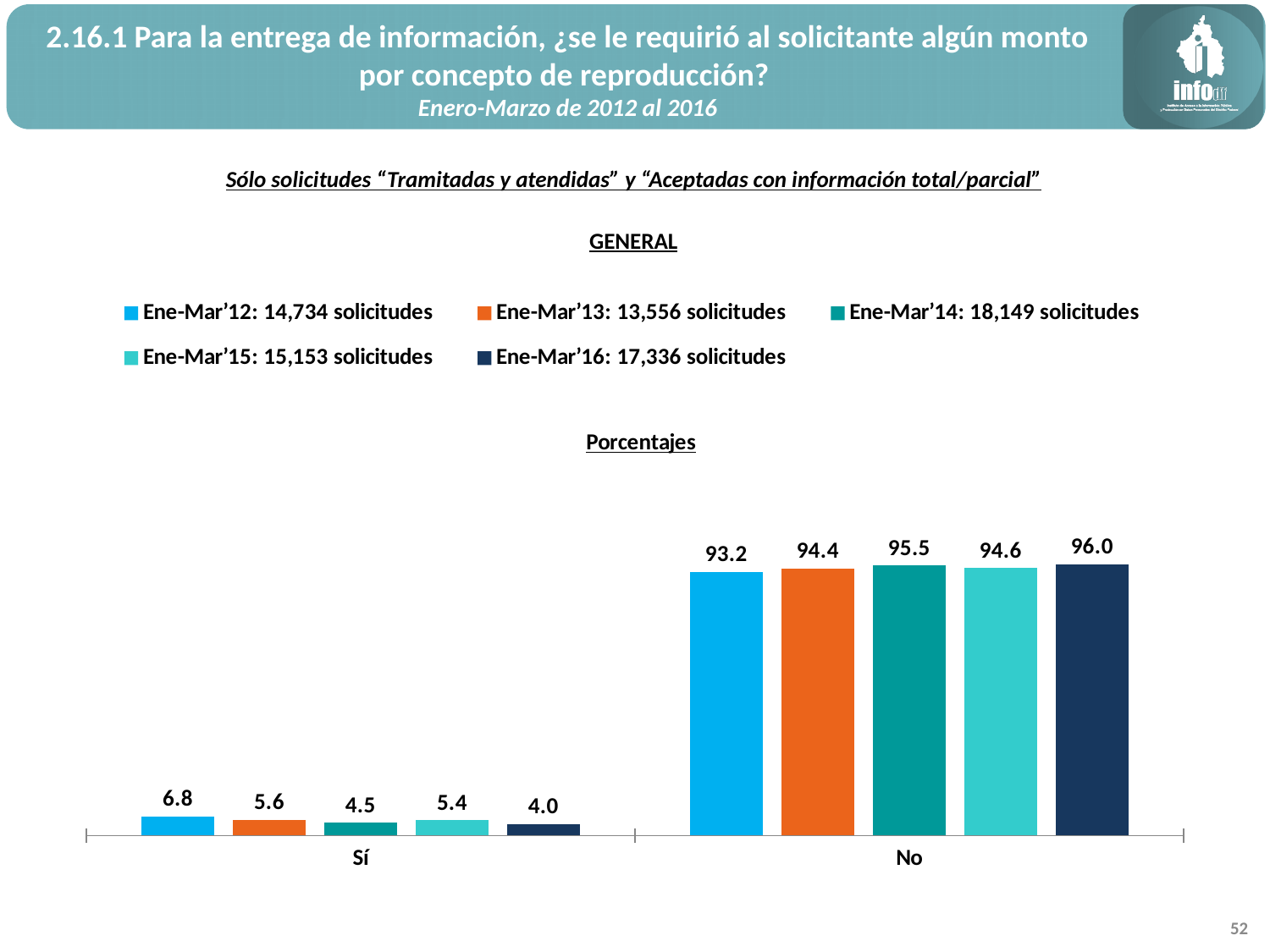
Which series has the lowest value in the Sí category? Ene-Mar'16 Which is larger in the No category: Ene-Mar'13 or Ene-Mar'15? Ene-Mar'15 What is the value for Ene-Mar'14 in the Sí category? 4.5 How many categories are shown on the x axis? 2 What is the value for Ene-Mar'12 in the Sí category? 6.8 Which series has the highest value in the No category? Ene-Mar'16 What is the difference between the Ene-Mar'14 and Ene-Mar'12 values in the No category? 2.3 How many series does the legend list? 5 How many solicitudes does the legend give for Ene-Mar'14? 18,149 solicitudes What is the difference between the Ene-Mar'12 and Ene-Mar'16 values in the Sí category? 2.8 What is the value for Ene-Mar'16 in the No category? 96.0 What kind of chart is shown on the slide? Bar chart